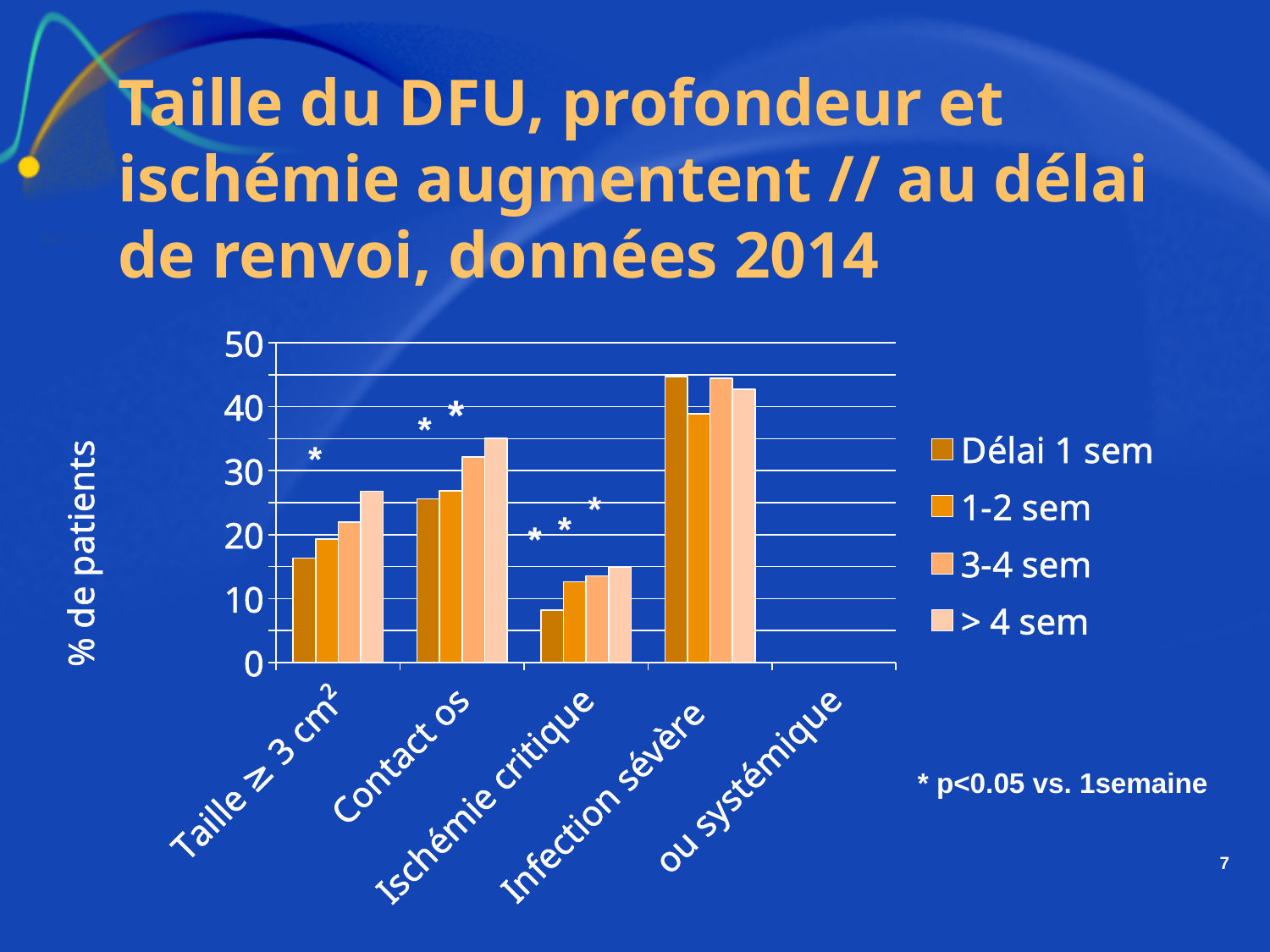
What does the asterisk (*) on the chart indicate, according to the footnote? p<0.05 vs. 1semaine Which category has the highest values across all series? Infection sévère Is the value for Délai 1 sem in the Taille ≥ 3 cm² category greater or less than 20? less Is the value for > 4 sem in the Ischémie critique category greater or less than 20? less What kind of chart is shown on the slide? bar chart Is the value for > 4 sem in the Contact os category greater or less than 30? greater For the > 4 sem series, which is larger: Contact os or Taille ≥ 3 cm²? Contact os What is the label of the vertical axis? % de patients How many series does the legend list? 4 For the Délai 1 sem series, which category has the lowest value? Ischémie critique